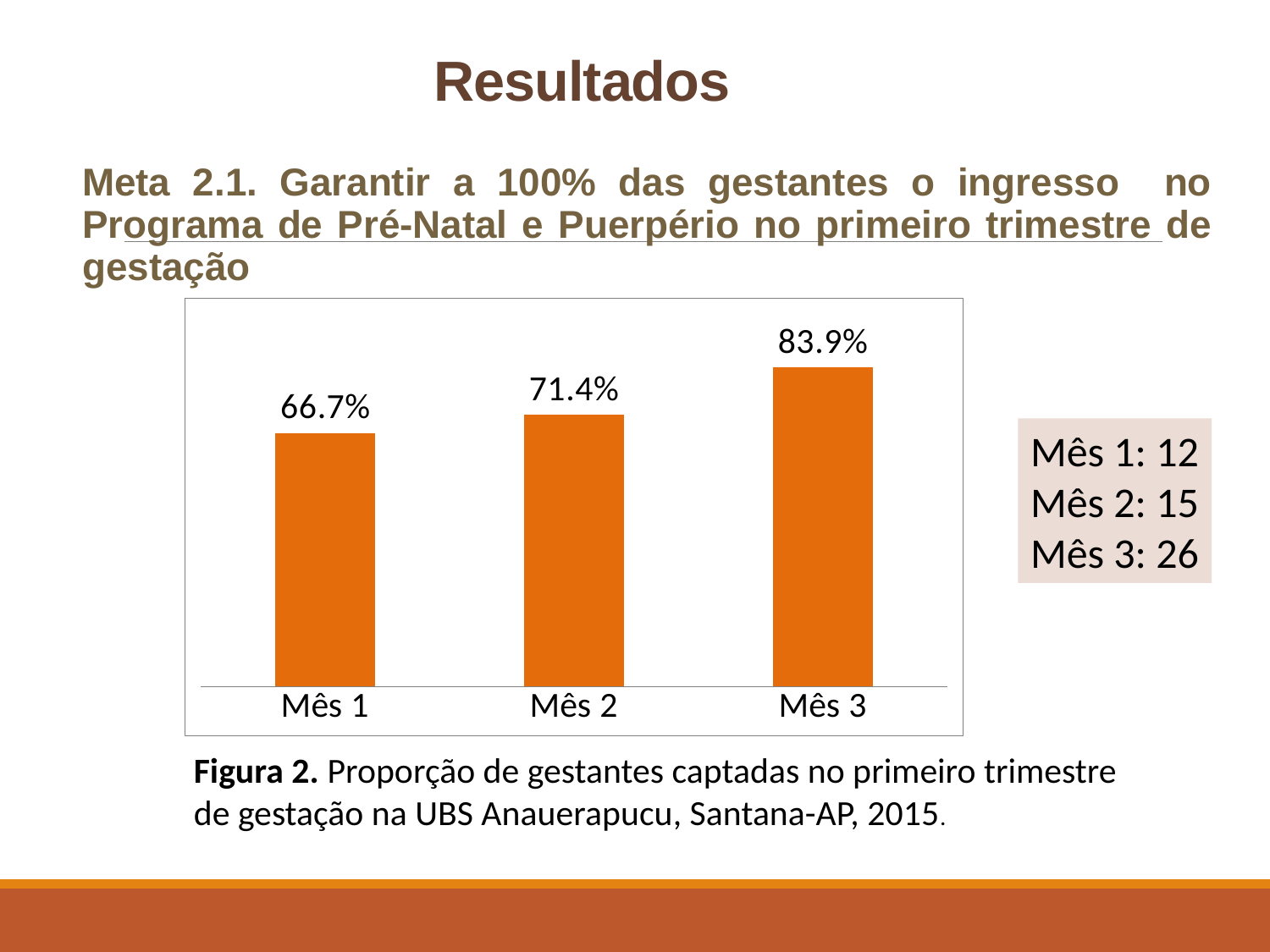
What is the value for Mês 1? 66.7% Do the values rise or fall from Mês 1 to Mês 3? Rise What is the value for Mês 2? 71.4% Which month has the highest value? Mês 3 Which month has the lowest value? Mês 1 Which is larger, the value for Mês 2 or the value for Mês 3? Mês 3 What kind of chart is shown on the slide? Bar chart What is the difference between the values for Mês 3 and Mês 1? 17.2% What colour are the bars in the chart? Orange What is the difference between the values for Mês 2 and Mês 1? 4.7% What is the value for Mês 3? 83.9% How many bars are shown in the chart? 3